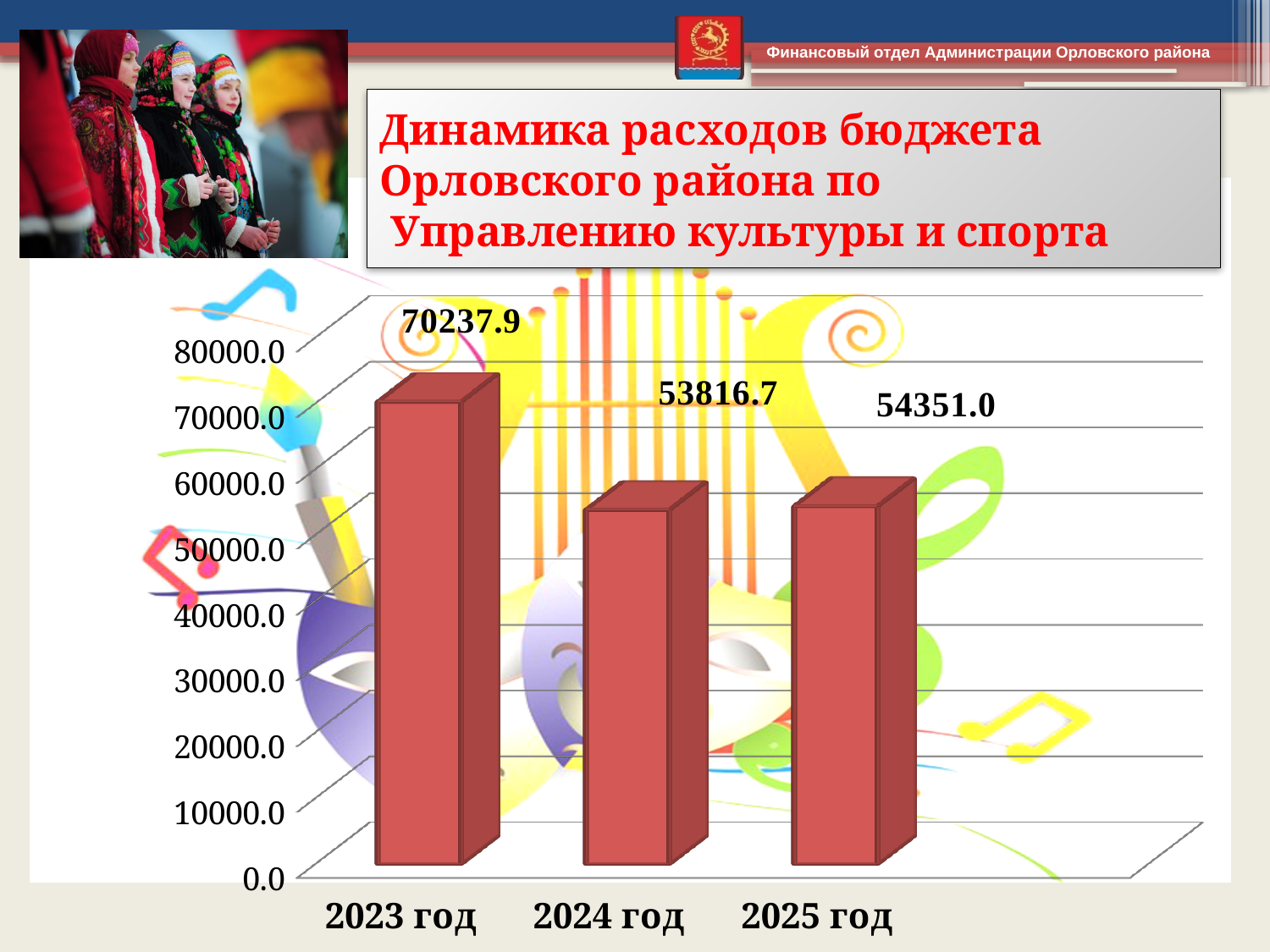
What is the value for 2023 год? 70237.9 Is the value for 2024 год greater or less than 60000.0? less What is the difference between the values for 2025 год and 2024 год? 534.3 What is the value for 2024 год? 53816.7 What is the value for 2025 год? 54351.0 Which year has the lowest value? 2024 год What kind of chart is shown on the slide? bar chart Does the value rise or fall from 2023 год to 2024 год? fall What is the difference between the values for 2023 год and 2024 год? 16421.2 Which is larger, the value for 2023 год or the value for 2025 год? 2023 год Which year has the highest value? 2023 год How many years are shown on the chart? 3